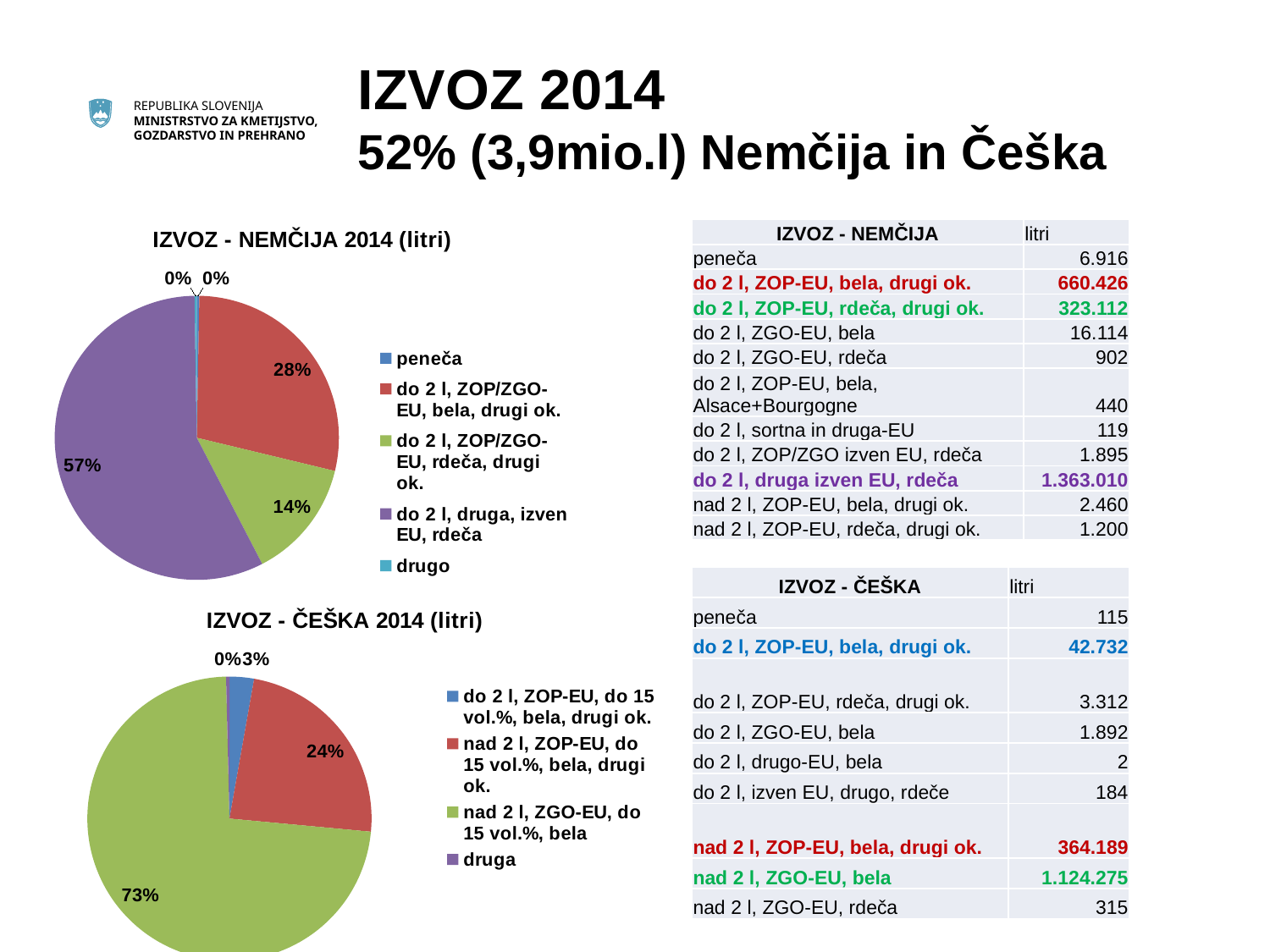
In the 'IZVOZ - ČEŠKA 2014 (litri)' chart, what share does 'nad 2 l, ZGO-EU, do 15 vol.%, bela' have? 73% In the 'IZVOZ - NEMČIJA 2014 (litri)' chart, how many legend entries are listed? 5 In the 'IZVOZ - ČEŠKA 2014 (litri)' chart, what share does 'nad 2 l, ZOP-EU, do 15 vol.%, bela, drugi ok.' have? 24% In the 'IZVOZ - ČEŠKA 2014 (litri)' chart, what share does 'do 2 l, ZOP-EU, do 15 vol.%, bela, drugi ok.' have? 3% In the 'IZVOZ - NEMČIJA 2014 (litri)' chart, which category has the largest slice? do 2 l, druga, izven EU, rdeča In the 'IZVOZ - NEMČIJA 2014 (litri)' chart, what is the difference in percentage points between the 'bela' slice (28%) and the 'rdeča' slice (14%)? 14 In the 'IZVOZ - ČEŠKA 2014 (litri)' chart, which category has the largest slice? nad 2 l, ZGO-EU, do 15 vol.%, bela What type of chart is 'IZVOZ - ČEŠKA 2014 (litri)'? pie chart In the 'IZVOZ - ČEŠKA 2014 (litri)' chart, how many legend entries are listed? 4